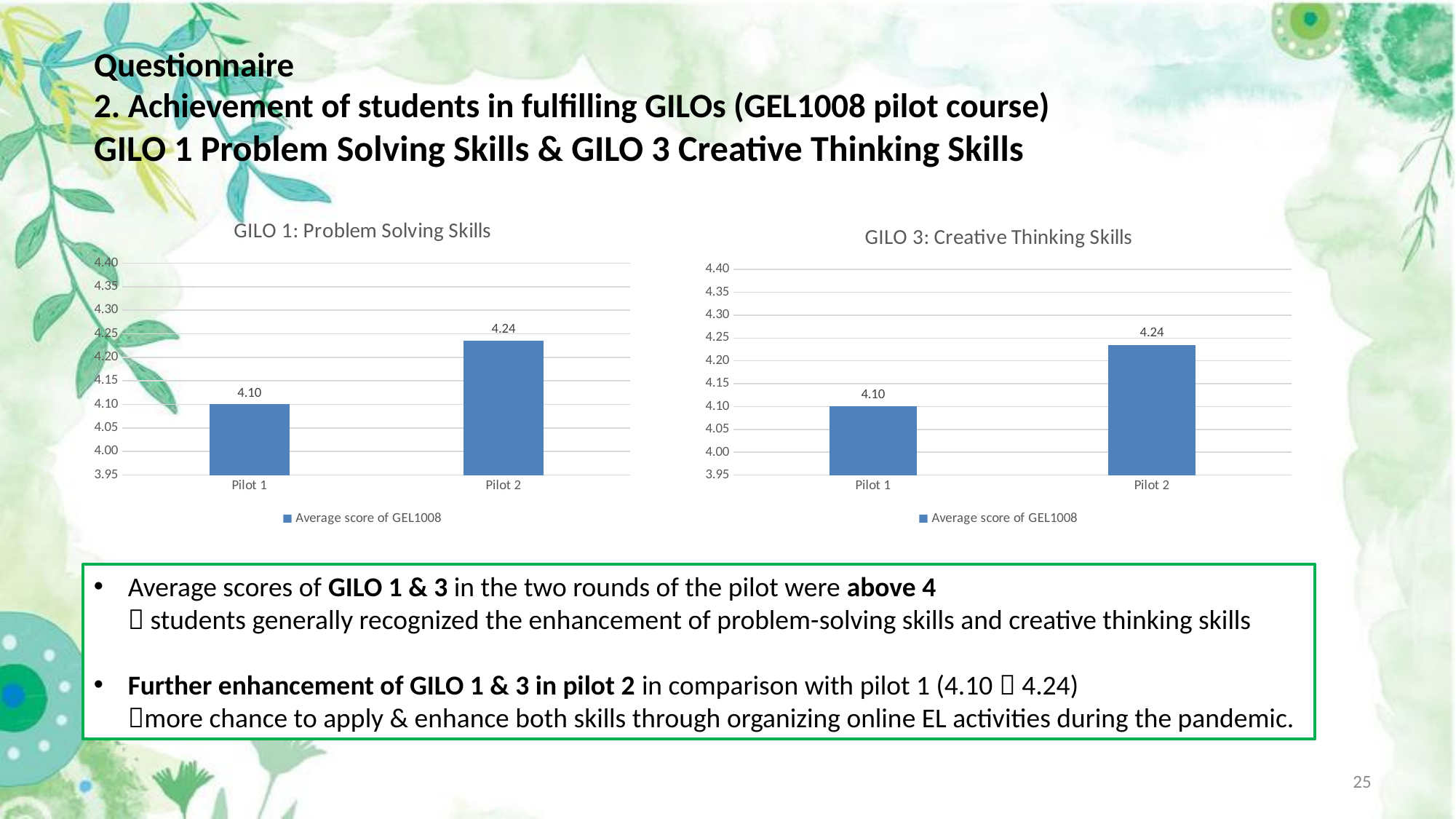
In the 'GILO 3: Creative Thinking Skills' chart, which category has the lowest value? Pilot 1 In the 'GILO 1: Problem Solving Skills' chart, which category has the highest value? Pilot 2 What is the legend entry in the 'GILO 3: Creative Thinking Skills' chart? Average score of GEL1008 In the 'GILO 1: Problem Solving Skills' chart, what is the difference between the Pilot 2 and Pilot 1 values? 0.14 What kind of chart is the 'GILO 1: Problem Solving Skills' chart? Bar chart In the 'GILO 3: Creative Thinking Skills' chart, is the value for Pilot 2 greater or less than 4.20? greater In the 'GILO 3: Creative Thinking Skills' chart, what is the value for Pilot 2? 4.24 In the 'GILO 1: Problem Solving Skills' chart, what is the value for Pilot 2? 4.24 In the 'GILO 3: Creative Thinking Skills' chart, what is the value for Pilot 1? 4.10 How many categories are shown in the 'GILO 1: Problem Solving Skills' chart? 2 In the 'GILO 1: Problem Solving Skills' chart, what is the value for Pilot 1? 4.10 How many series does the legend of the 'GILO 3: Creative Thinking Skills' chart list? 1